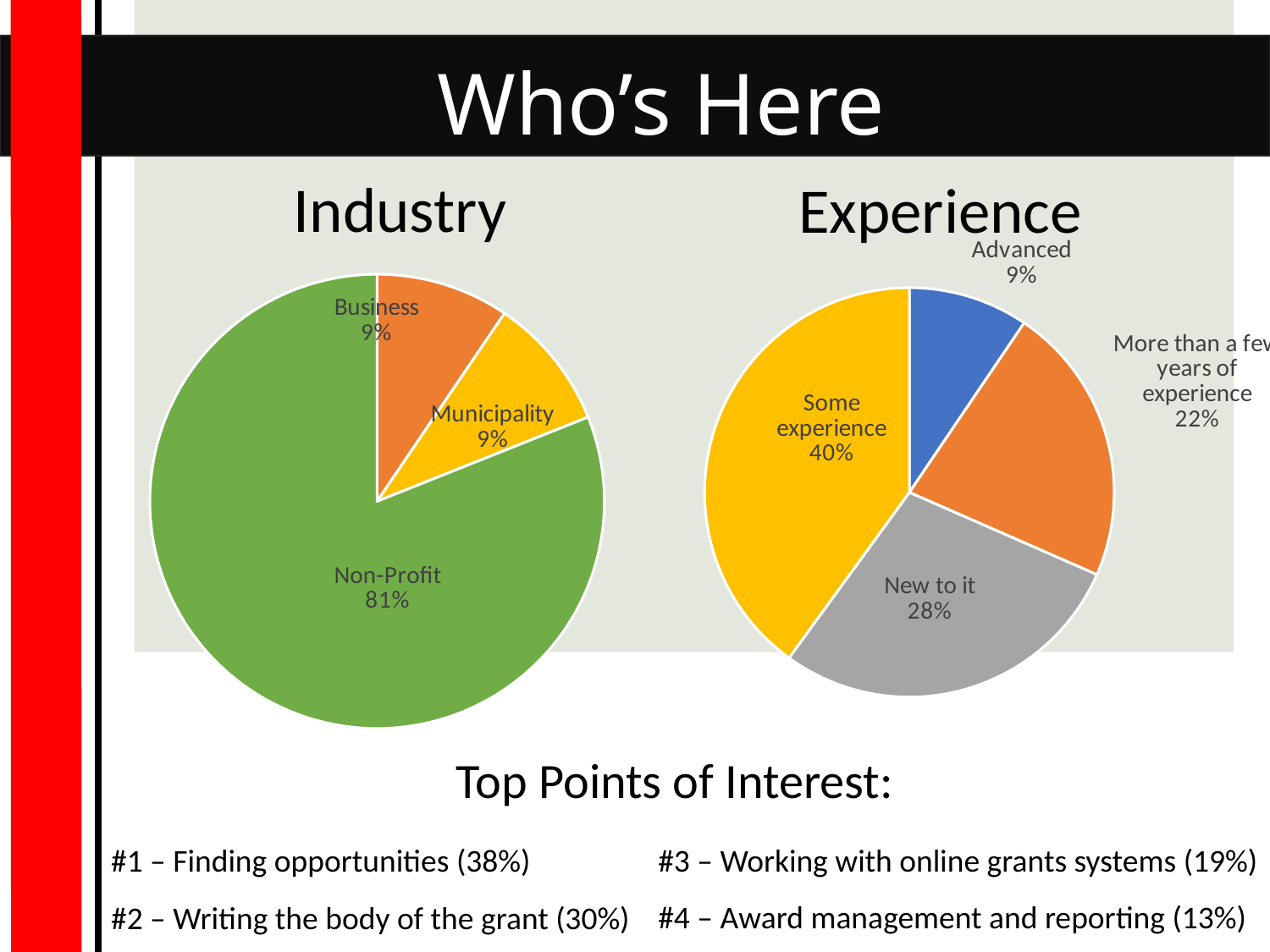
In the Industry pie chart, what share is Business? 9% In the Industry pie chart, which category has the largest slice? Non-Profit In the Experience pie chart, which category has the largest slice? Some experience In the Industry pie chart, what share is Non-Profit? 81% How many slices does the Experience pie chart have? 4 In the Experience pie chart, what is the difference between Some experience and New to it? 12% In the Experience pie chart, which category has the smallest slice? Advanced What type of chart is the Industry chart? Pie chart In the Experience pie chart, what share is Advanced? 9% How many slices does the Industry pie chart have? 3